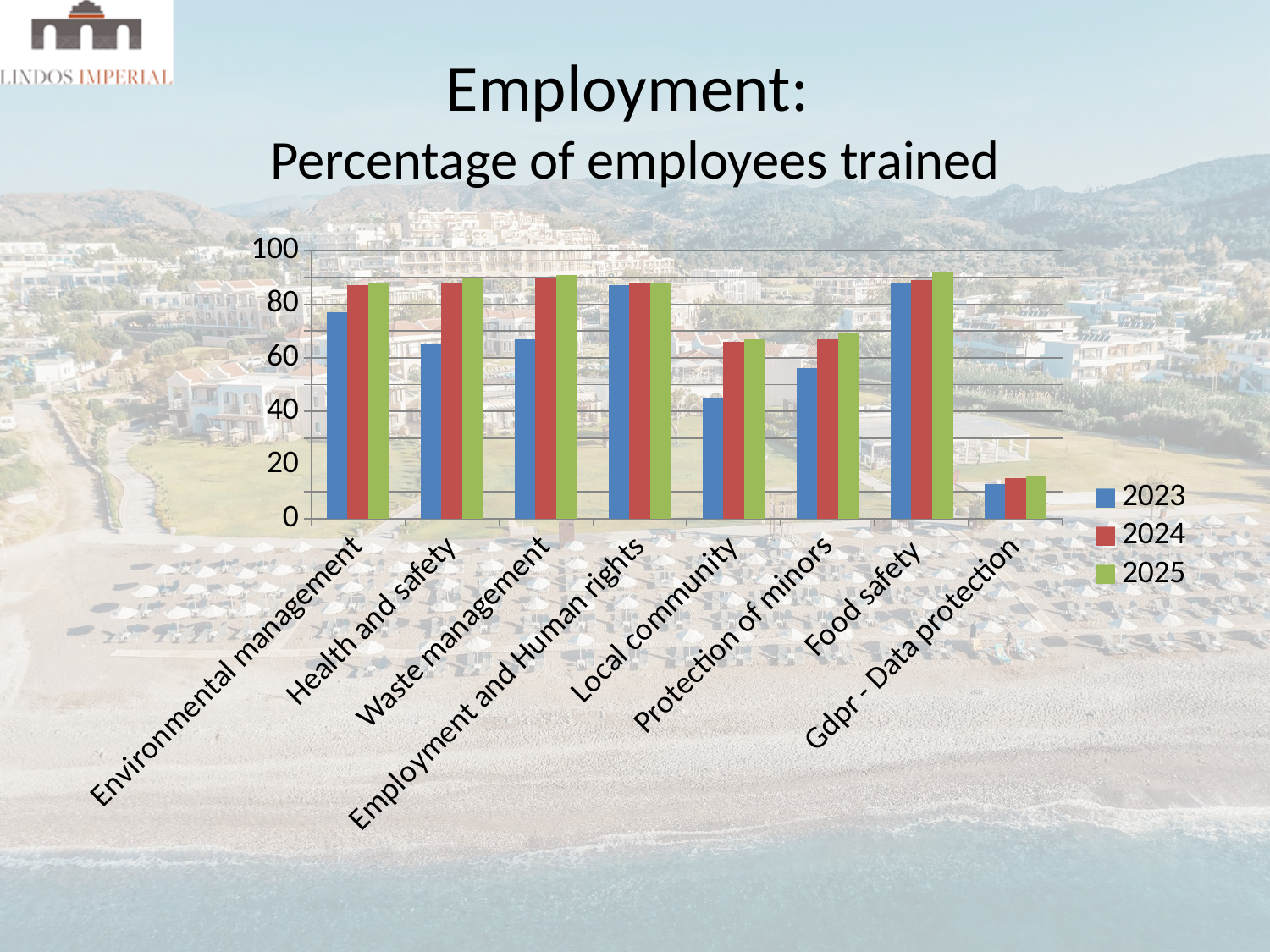
Which is larger for 2023: Local community or Protection of minors? Protection of minors Which category has the lowest value for 2023? Gdpr - Data protection Which is larger for 2023: Health and safety or Food safety? Food safety Is the 2023 value for Local community greater or less than 60? less For Local community, do the values rise or fall from 2023 to 2025? rise What years are listed in the legend? 2023, 2024, 2025 Is the 2025 value for Gdpr - Data protection greater or less than 20? less What kind of chart is shown on the slide? bar chart Is the 2024 value for Environmental management greater or less than 80? greater How many training categories are shown on the x axis? 8 How many series does the legend list? 3